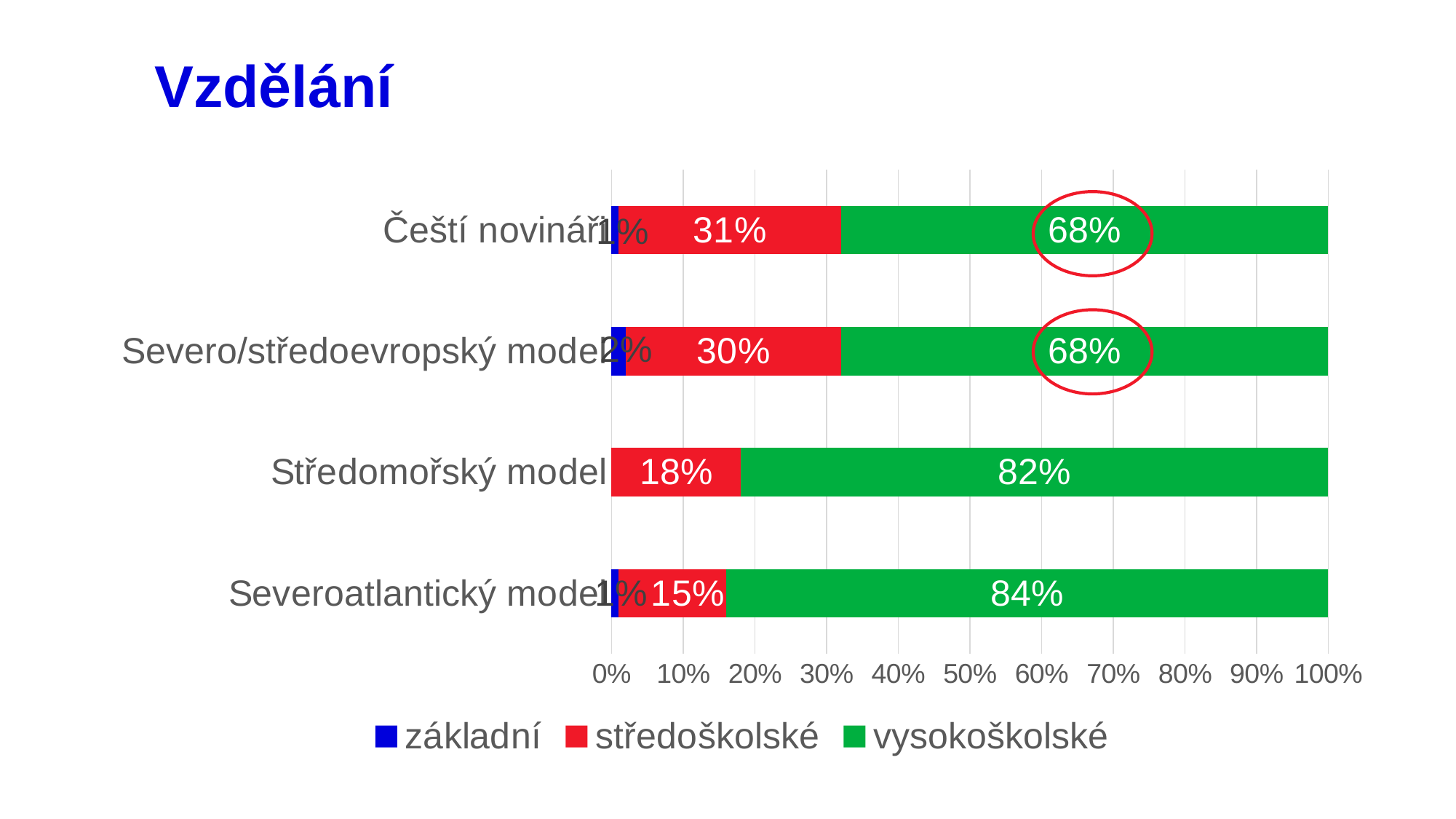
What is the title of the slide? Vzdělání Which category has the highest vysokoškolské value? Severoatlantický model How many categories are shown on the chart? 4 Which category has the lowest středoškolské value? Severoatlantický model What is the vysokoškolské value for Čeští novináři? 68% Which is larger, the středoškolské value for Čeští novináři or for Středomořský model? Čeští novináři What is the středoškolské value for Severoatlantický model? 15% What is the základní value for Severo/středoevropský model? 2% What kind of chart is shown on the slide? stacked bar chart How many series does the legend list? 3 What is the difference between the vysokoškolské values for Severoatlantický model and Čeští novináři? 16% What is the vysokoškolské value for Středomořský model? 82%